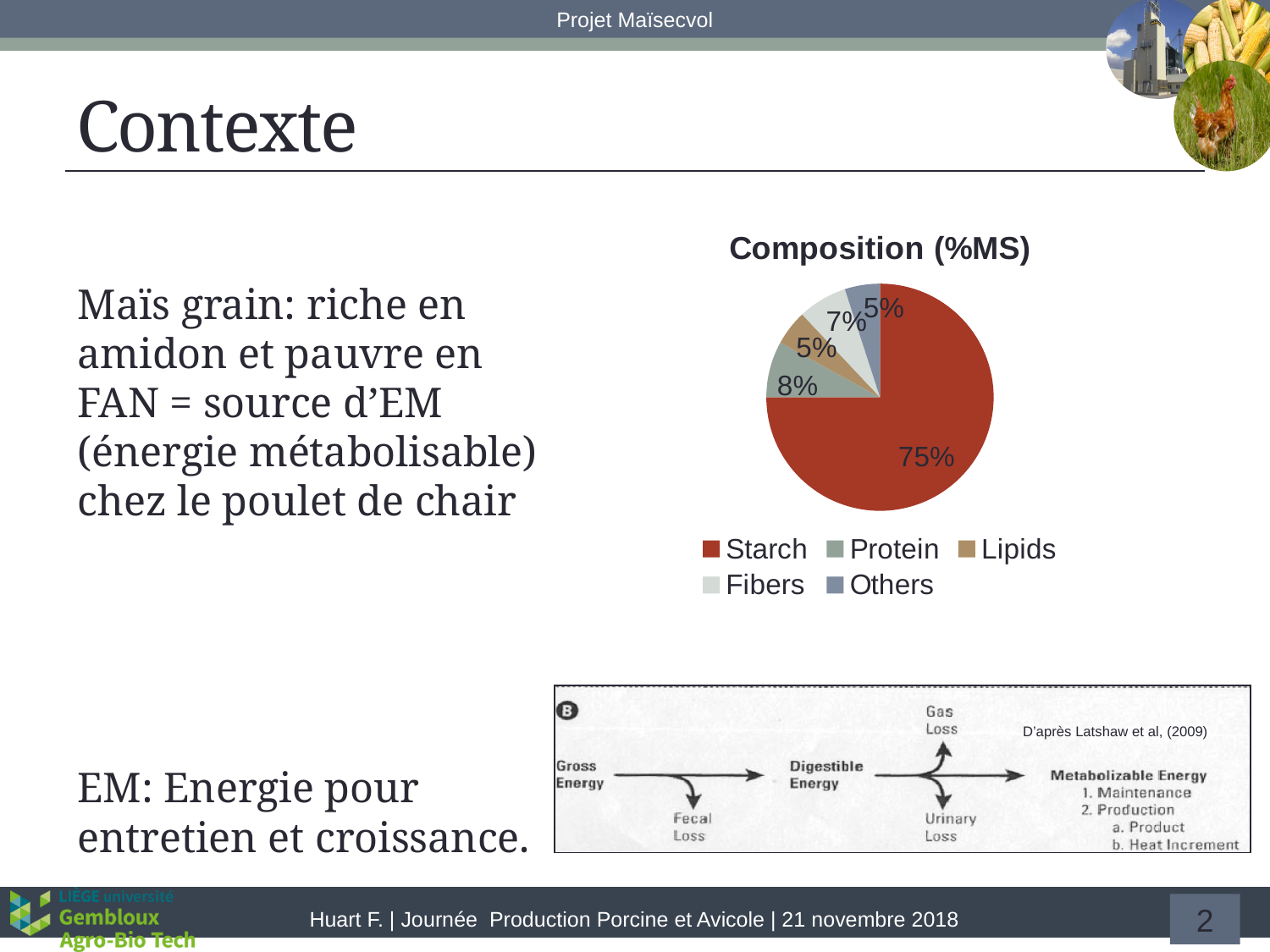
Which category has the largest slice in the Composition (%MS) pie chart? Starch What is the value for Protein in the Composition (%MS) pie chart? 8% In the Composition (%MS) pie chart, which is larger, Protein or Lipids? Protein What is the value for Others in the Composition (%MS) pie chart? 5% How many categories does the legend of the Composition (%MS) pie chart list? 5 What is the value for Lipids in the Composition (%MS) pie chart? 5% What type of chart is shown under the title "Composition (%MS)"? pie chart What is the difference between the Protein and Fibers values in the Composition (%MS) pie chart? 1% What is the value for Fibers in the Composition (%MS) pie chart? 7% What is the value for Starch in the Composition (%MS) pie chart? 75% What is the title of the pie chart on the slide? Composition (%MS) What is the difference between the Starch and Protein values in the Composition (%MS) pie chart? 67%